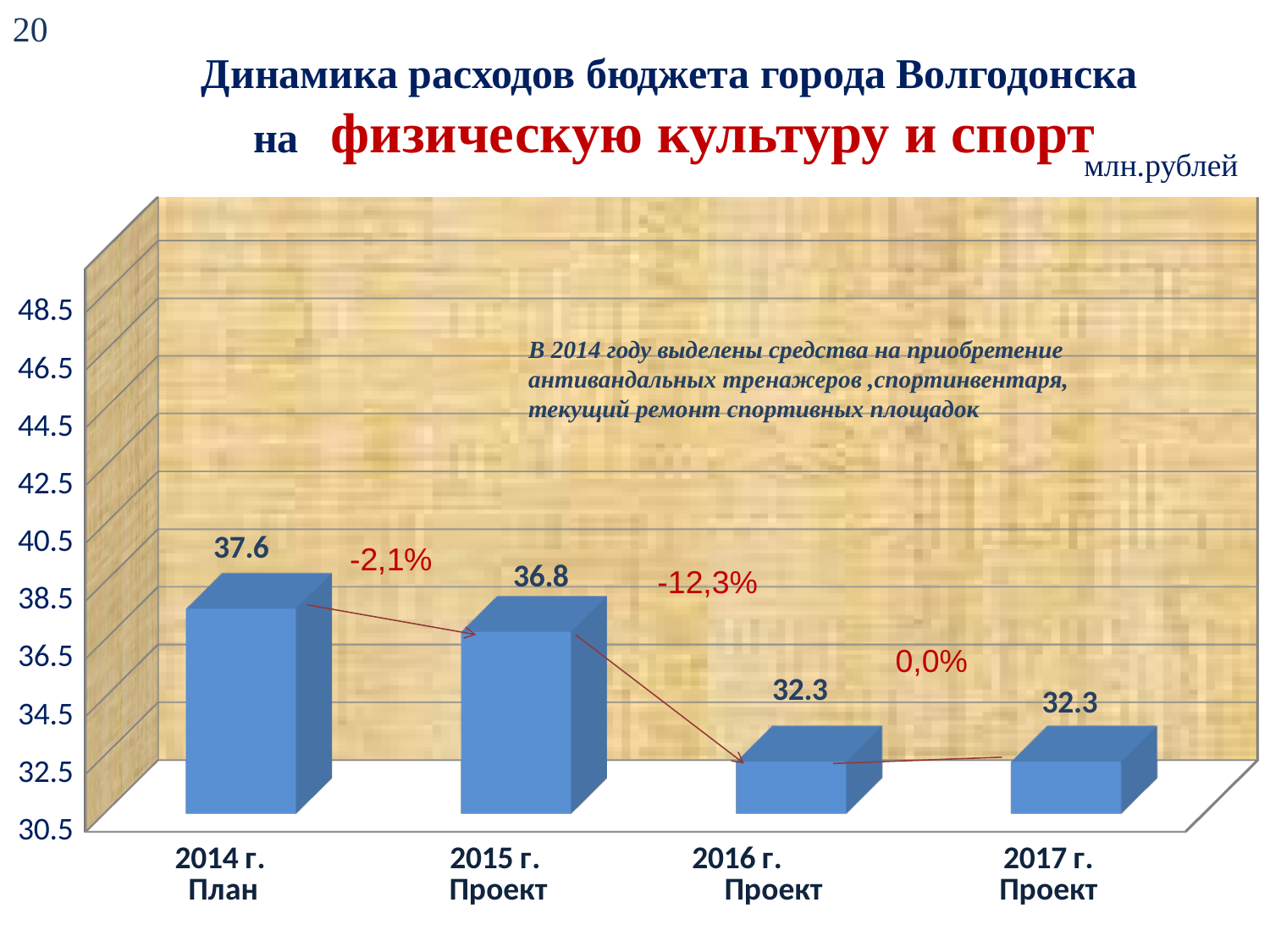
What percentage change is shown between 2015 г. Проект and 2016 г. Проект? -12,3% Which category has the highest value? 2014 г. План Which is larger, the value for 2015 г. Проект or the value for 2017 г. Проект? 2015 г. Проект What unit of measurement is indicated for the chart? млн.рублей What is the value for 2014 г. План? 37.6 What is the difference between the values for 2015 г. Проект and 2016 г. Проект? 4.5 What is the value for 2016 г. Проект? 32.3 How many categories are shown on the x axis? 4 Do the values rise or fall from 2014 г. План to 2016 г. Проект? fall What is the difference between the values for 2014 г. План and 2015 г. Проект? 0.8 What kind of chart is shown on the slide? bar chart What is the value for 2015 г. Проект? 36.8